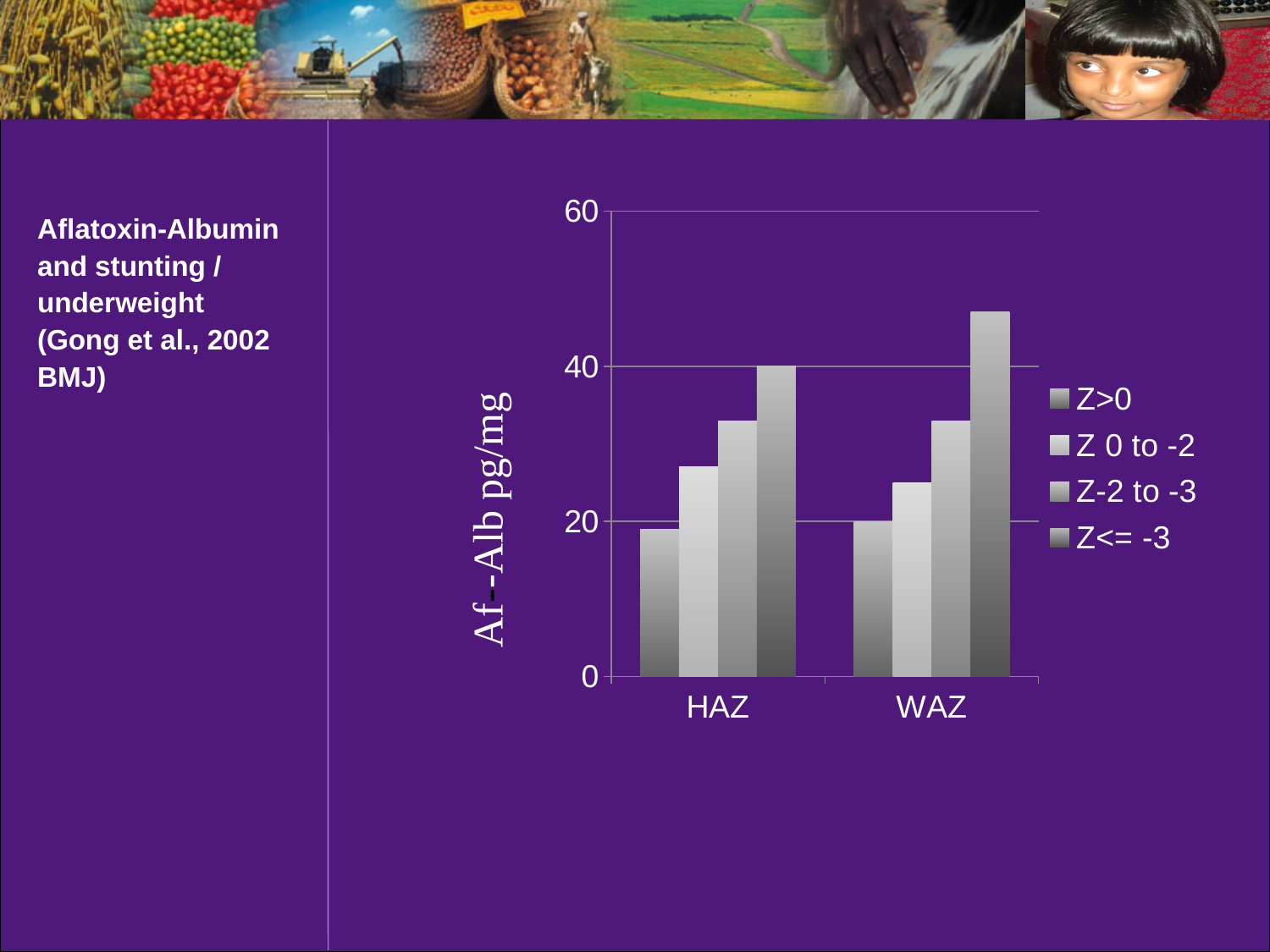
Which legend entry is listed last in the chart's legend? Z<= -3 What is the label of the y axis of the chart? Af-Alb pg/mg Which series has the lowest bar in the HAZ group? Z>0 Is the value for Z-2 to -3 in the WAZ group greater or less than 40? less Which series has the highest bar in the WAZ group? Z<= -3 How many categories are shown on the x axis of the chart? 2 What kind of chart is shown on the slide? bar chart How many series does the chart's legend list? 4 Is the value for Z 0 to -2 in the HAZ group greater or less than 20? greater Is the value for Z<= -3 in the WAZ group greater or less than 40? greater Which bar is the tallest in the whole chart? Z<= -3 for WAZ Which is larger, the Z<= -3 value for HAZ or the Z<= -3 value for WAZ? WAZ